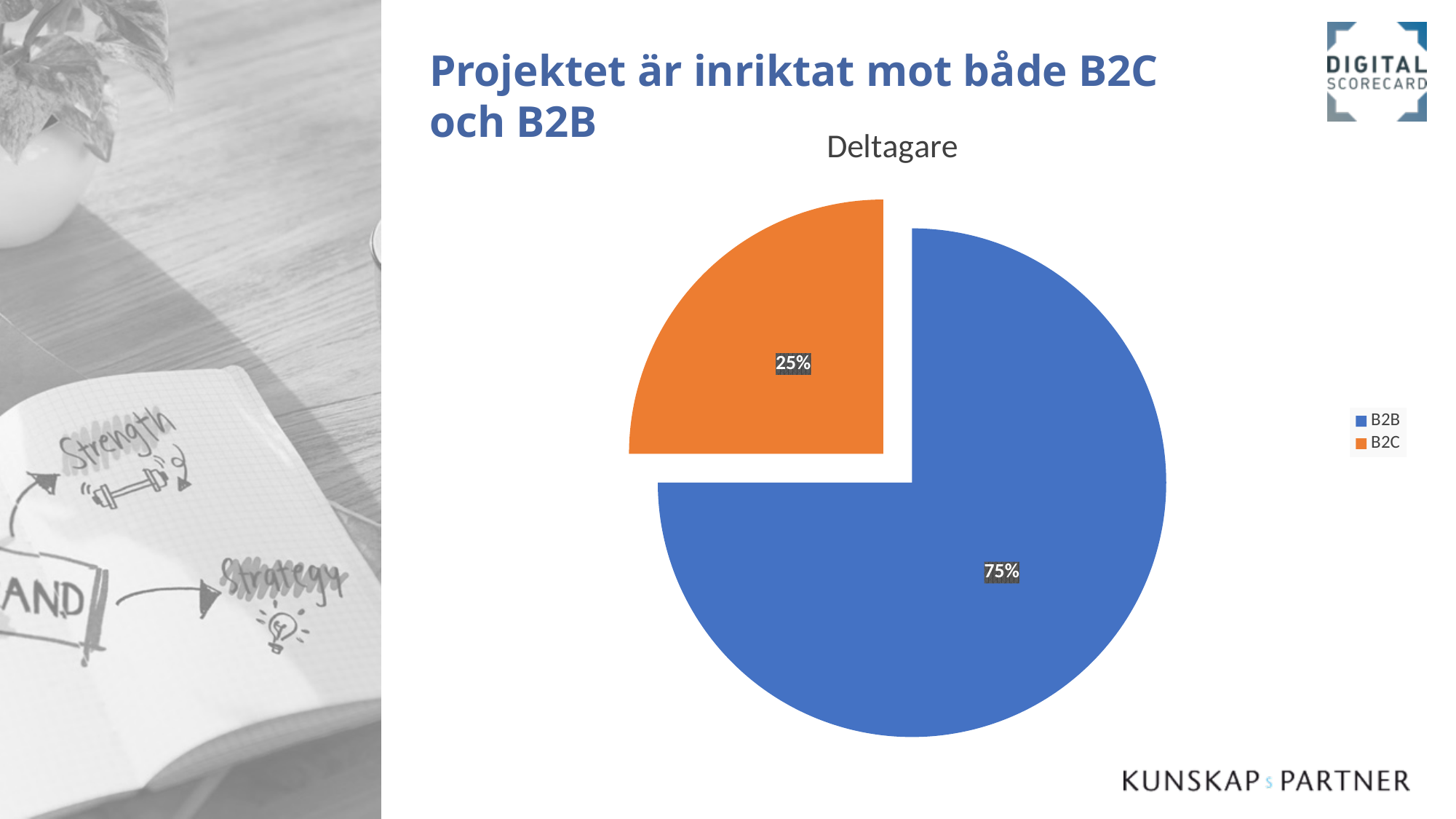
Which category has the largest slice of the pie? B2B What is the difference in percentage points between the B2B and B2C slices? 50 What kind of chart is shown on the slide? Pie chart What colour is the B2C slice? Orange How many entries does the legend list? 2 Which is larger, the B2B slice or the B2C slice? B2B Which category has the smallest slice of the pie? B2C How many slices does the pie chart have? 2 What is the title of the chart? Deltagare What share of the pie does B2B represent? 75% What share of the pie does B2C represent? 25%